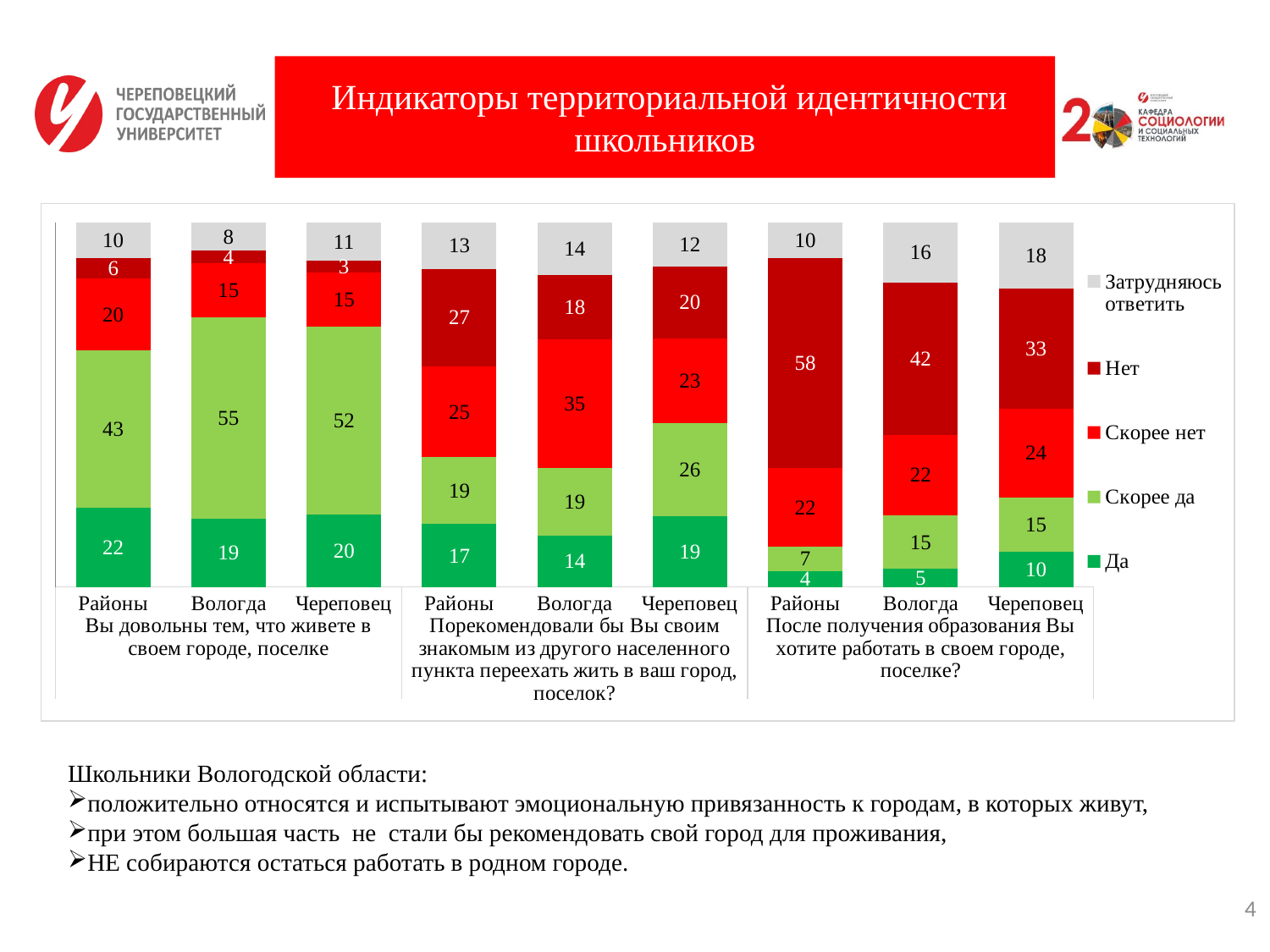
What is the value of "Скорее нет" for Вологда in the group "Порекомендовали бы Вы своим знакомым из другого населенного пункта переехать жить в ваш город, поселок?"? 35 What is the value of "Скорее да" for Вологда in the group "Вы довольны тем, что живете в своем городе, поселке"? 55 In the group "После получения образования Вы хотите работать в своем городе, поселке?", which category has the highest "Нет" value? Районы How many bars are plotted in the chart in total? 9 Which colour represents the "Затрудняюсь ответить" series in the legend? grey What kind of chart is shown on the slide? stacked bar chart In the group "Порекомендовали бы Вы своим знакомым из другого населенного пункта переехать жить в ваш город, поселок?", is the "Скорее да" value larger for Череповец or for Вологда? Череповец What is the value of "Да" for Череповец in the group "После получения образования Вы хотите работать в своем городе, поселке?"? 10 In the group "Вы довольны тем, что живете в своем городе, поселке", which category has the lowest "Нет" value? Череповец What is the difference between the "Нет" values for Районы and Череповец in the group "После получения образования Вы хотите работать в своем городе, поселке?"? 25 How many series does the legend list? 5 What is the value of "Нет" for Районы in the group "После получения образования Вы хотите работать в своем городе, поселке?"? 58